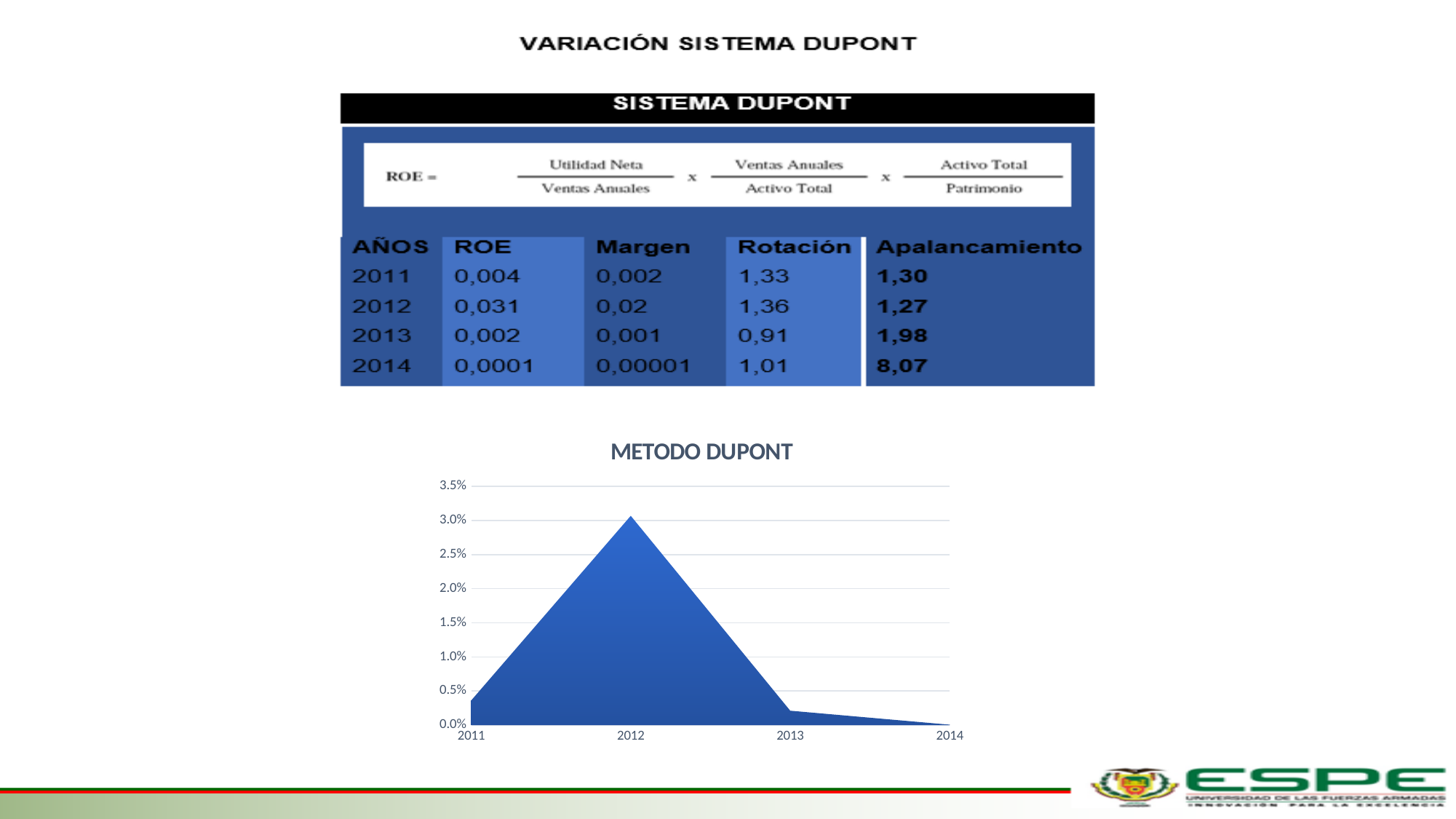
In the METODO DUPONT chart, is the value for 2011 greater or less than 0.5%? less In the METODO DUPONT chart, do the values rise or fall from 2012 to 2014? fall In the METODO DUPONT chart, which year has the highest value? 2012 What is the highest tick shown on the y axis of the METODO DUPONT chart? 3.5% In the METODO DUPONT chart, do the values rise or fall from 2011 to 2012? rise What is the title of the chart at the bottom of the slide? METODO DUPONT In the METODO DUPONT chart, which year has the lowest value? 2014 What kind of chart is the METODO DUPONT chart? area chart In the METODO DUPONT chart, is the value for 2013 greater or less than 1.0%? less In the METODO DUPONT chart, is the value for 2012 greater or less than 2.5%? greater In the METODO DUPONT chart, which is larger, the value for 2011 or the value for 2013? 2011 How many years are plotted on the x axis of the METODO DUPONT chart? 4